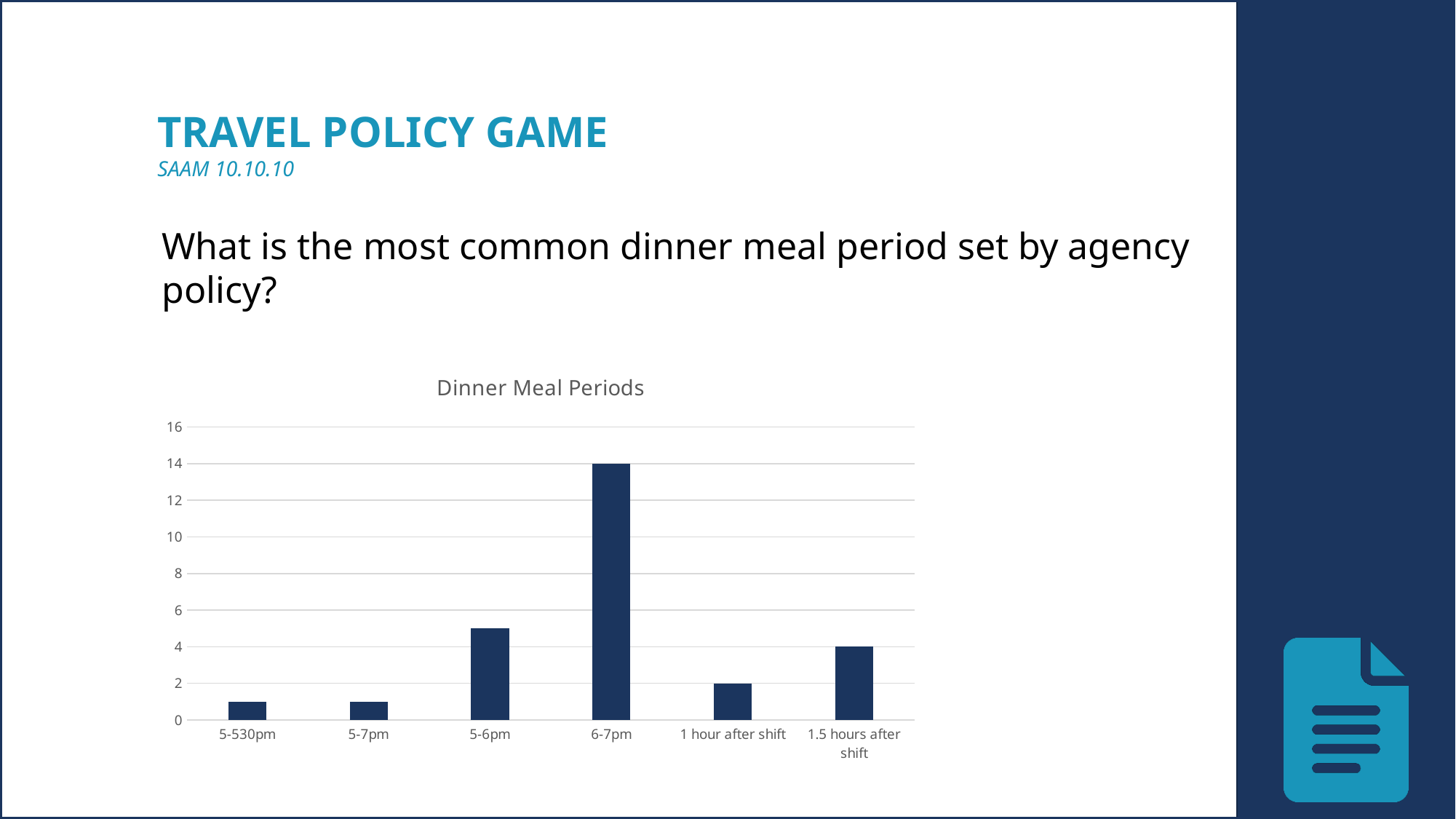
What is the difference between the values for 6-7pm and 1.5 hours after shift? 10 Is the value for 5-6pm greater or less than 6? less What is the value for 1.5 hours after shift in the chart? 4 What is the title of the chart? Dinner Meal Periods Which has a larger value, 5-6pm or 1.5 hours after shift? 5-6pm What is the value for 6-7pm in the chart? 14 What is the value for 1 hour after shift in the chart? 2 Is the value for 5-530pm greater or less than 2? less Which dinner meal period has the highest value in the chart? 6-7pm What kind of chart is shown on the slide? bar chart How many categories are shown on the x axis of the chart? 6 What is the difference between the values for 1.5 hours after shift and 1 hour after shift? 2